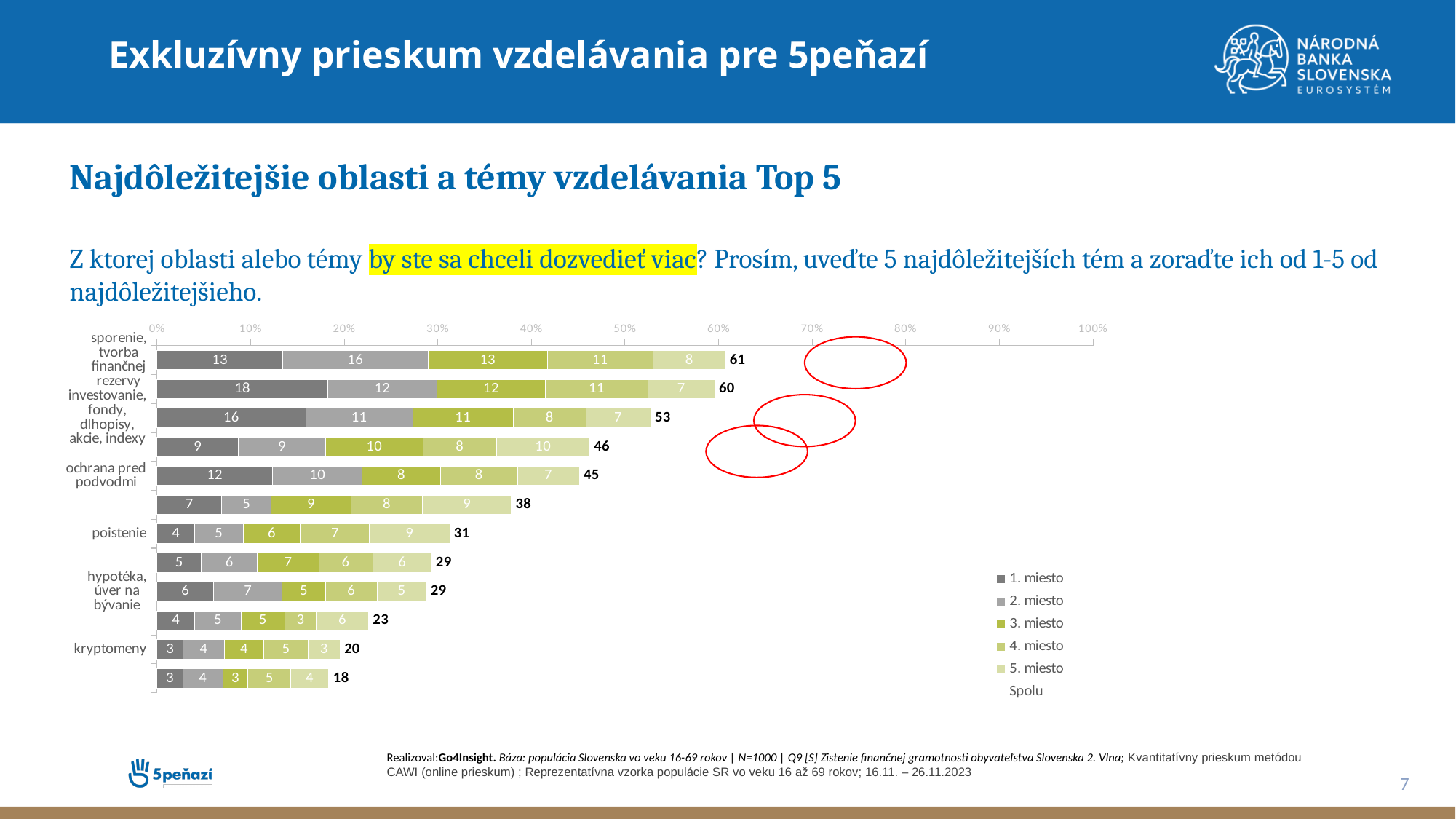
Which has a larger total, 'poistenie' or 'kryptomeny'? poistenie What is the total (Spolu) value for 'poistenie'? 31 What is the last entry listed in the chart legend? Spolu How many entries does the chart legend list? 6 What is the total (Spolu) value for 'ochrana pred podvodmi'? 45 What is the difference between the total for 'ochrana pred podvodmi' and the total for 'poistenie'? 14 What kind of chart is shown on the slide? stacked bar chart What is the highest total value shown in the chart? 61 What is the lowest total value shown in the chart? 18 How many bars (categories) does the chart show? 12 What is the total (Spolu) value for 'kryptomeny'? 20 What is the '1. miesto' value for 'ochrana pred podvodmi'? 12